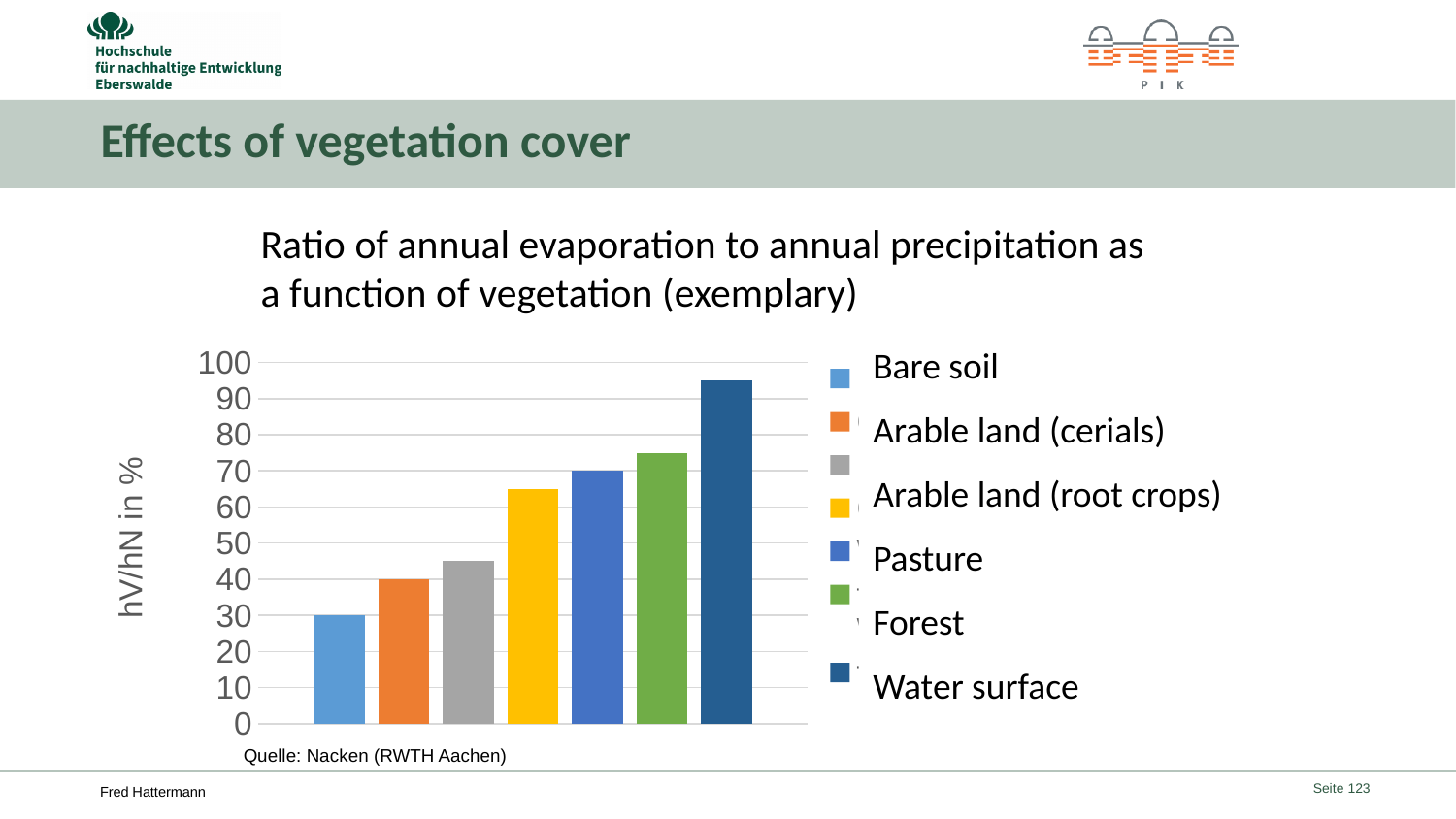
What is the hV/hN value in % for Bare soil? 30 Is the value of the gray (third) bar greater or less than 50? less Which is larger, the value for Bare soil or the value for Water surface? Water surface What is the label on the vertical axis of the chart? hV/hN in % Do the bar values rise or fall from left to right across the chart? rise Which category has the lowest bar in the chart? Bare soil Is the value of the yellow (fourth) bar greater or less than 60? greater Is the value for Water surface greater or less than 90? greater What kind of chart is shown on the slide? bar chart How many labelled entries does the legend list? 6 How many bars are plotted in the chart? 7 Which category has the highest bar in the chart? Water surface